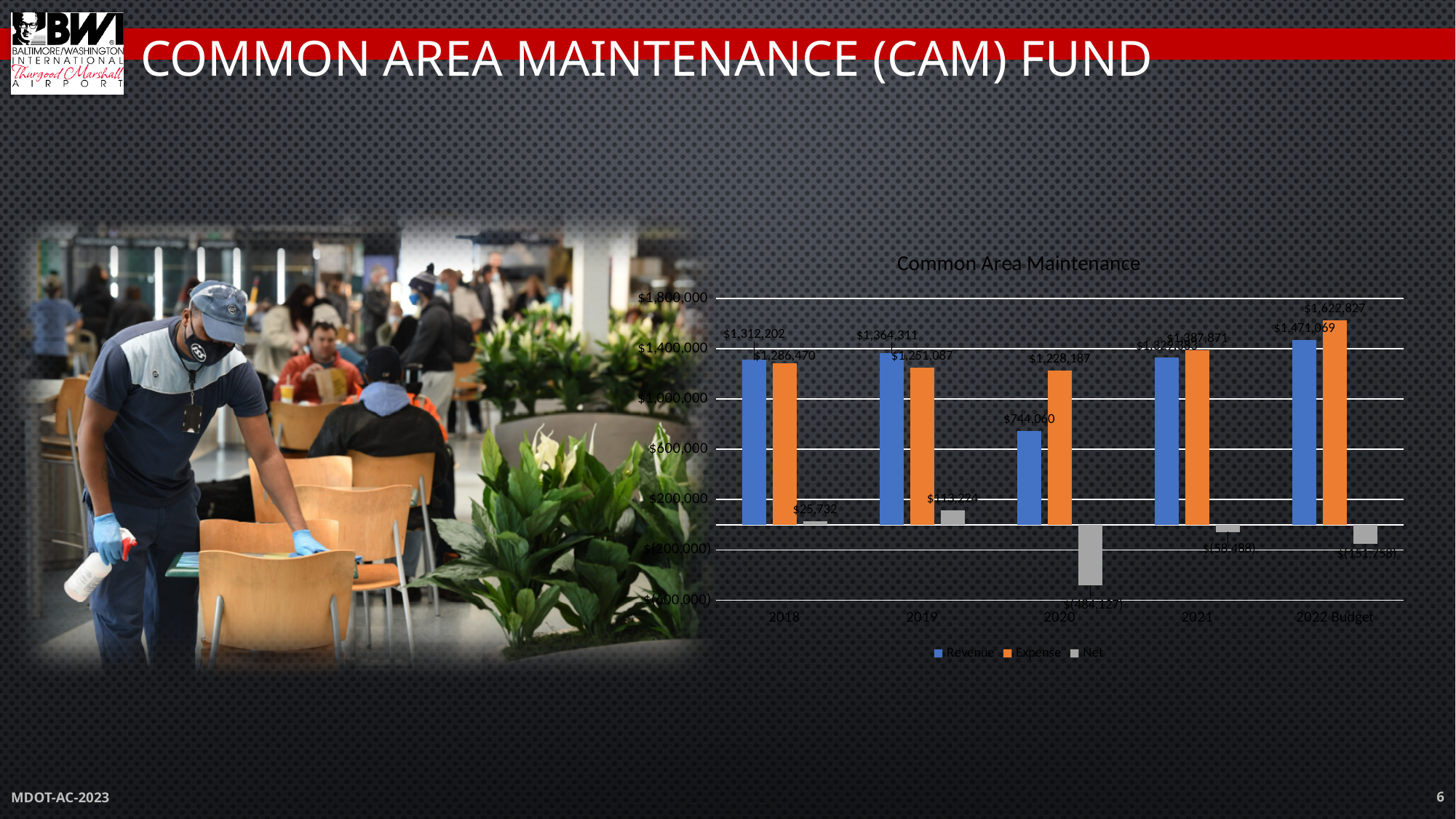
What is the Net value for 2020 in the Common Area Maintenance chart? $(484,127) What kind of chart is shown on the slide? Bar chart How many series does the legend of the Common Area Maintenance chart list? 3 In the Common Area Maintenance chart, what is the difference between Revenue and Expense for 2019? $113,224 How many categories are shown along the x axis of the Common Area Maintenance chart? 5 In the Common Area Maintenance chart, which is larger for 2020: Revenue or Expense? Expense What is the title of the chart on the slide? Common Area Maintenance What is the Revenue value for 2018 in the Common Area Maintenance chart? $1,312,202 What is the Expense value for 2022 Budget in the Common Area Maintenance chart? $1,622,827 Which category has the lowest Revenue in the Common Area Maintenance chart? 2020 Which category has the highest Expense in the Common Area Maintenance chart? 2022 Budget In the Common Area Maintenance chart, is the Revenue value for 2020 greater or less than $1,000,000? less